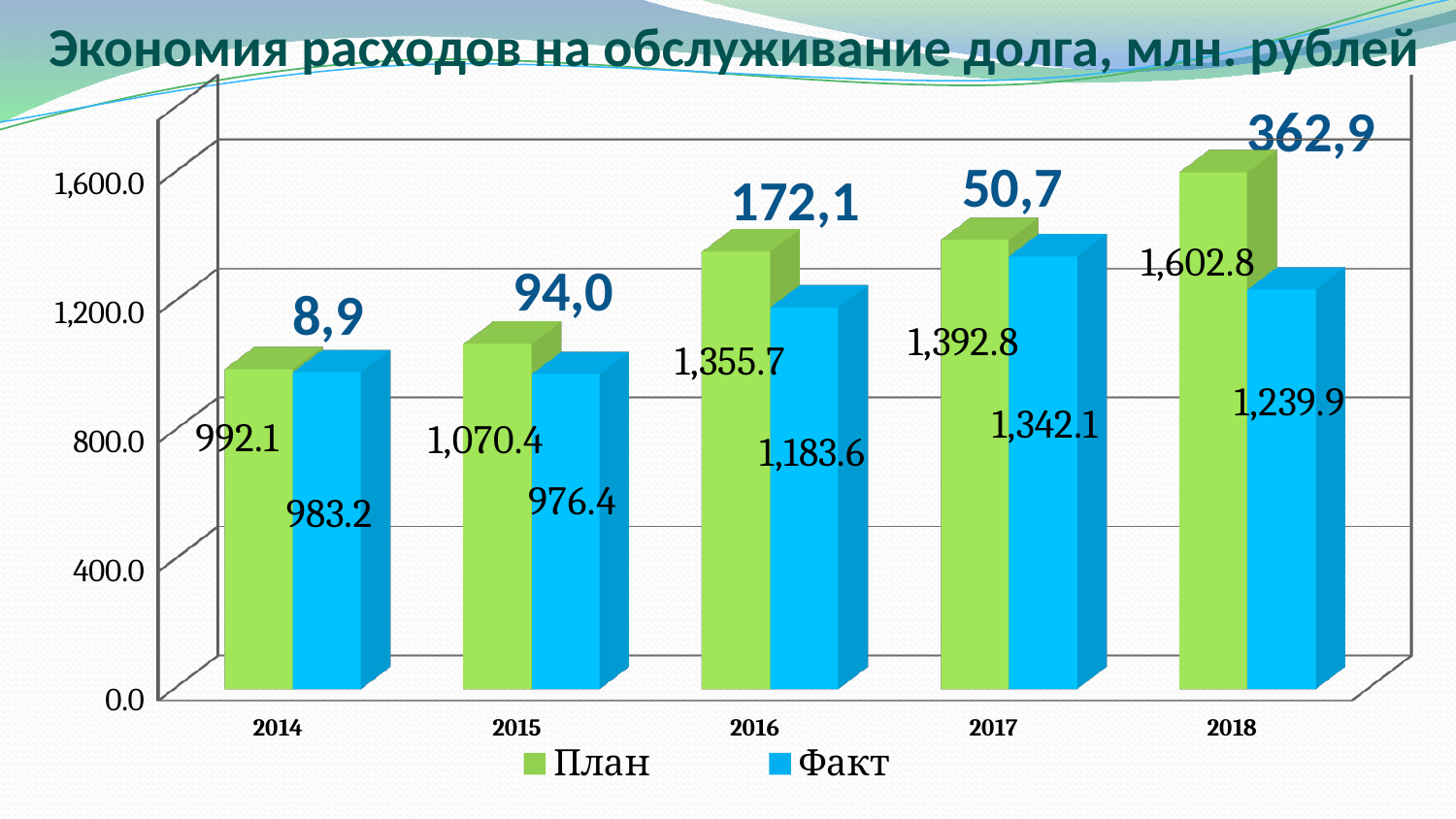
Do the План values rise or fall from 2014 to 2018? rise Which year has the lowest Факт value? 2015 What is the Факт value for 2015? 976.4 Which is larger in 2017, the План value or the Факт value? План What is the План value for 2016? 1,355.7 What kind of chart is shown on the slide? bar chart What is the Факт value for 2018? 1,239.9 How many years are shown on the x axis? 5 How many series does the legend list? 2 What is the difference between the План and Факт values for 2018? 362.9 Is the Факт value for 2016 greater or less than 1,200.0? less Which year has the highest План value? 2018